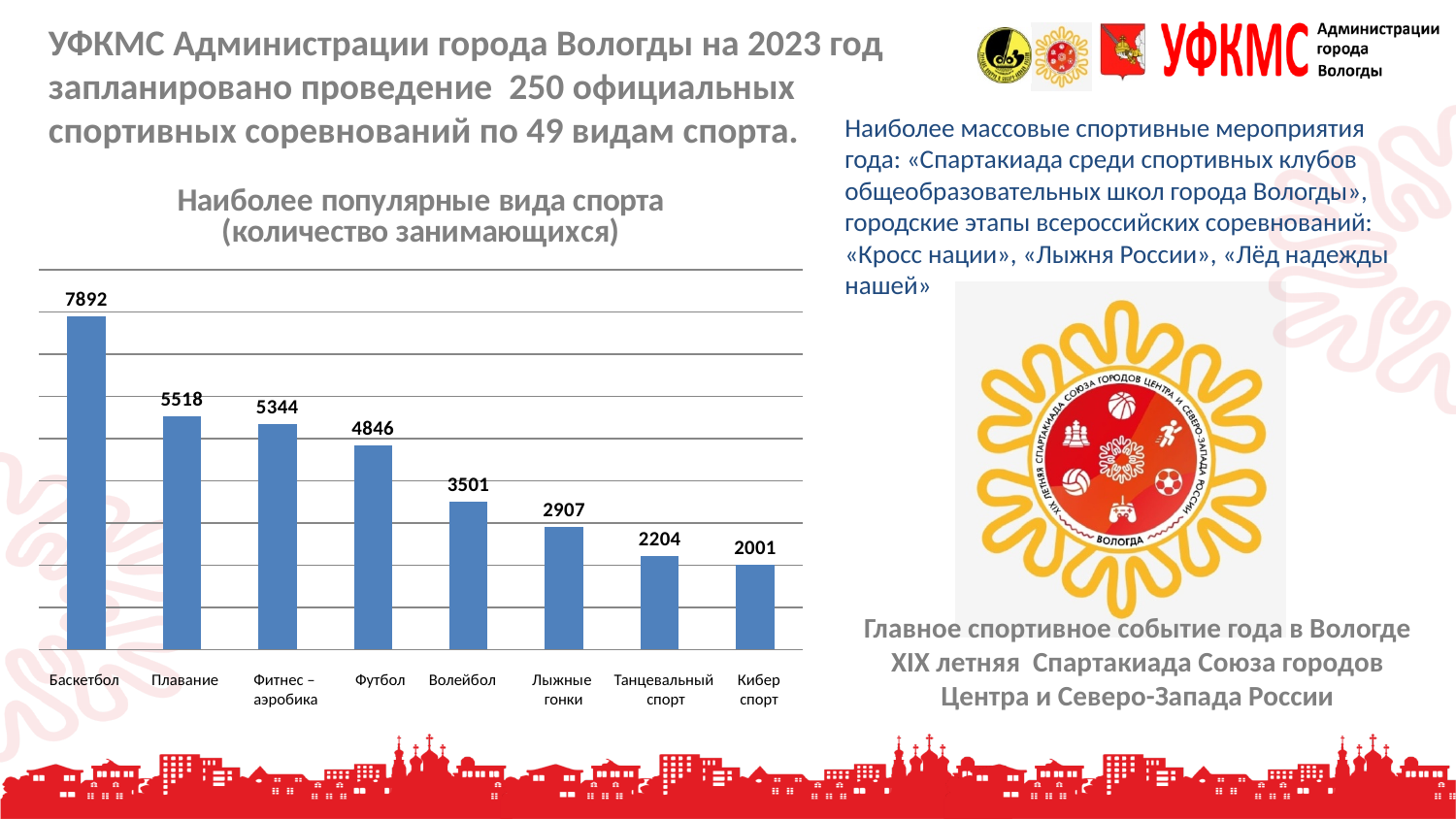
Which category has the highest value? Баскетбол Which category has the lowest value? Кибер спорт What is the value for Волейбол? 3501 What is the value for Баскетбол? 7892 Do the values rise or fall from left to right along the x axis? fall What is the value for Лыжные гонки? 2907 What is the difference between the values for Танцевальный спорт and Кибер спорт? 203 Which is larger, the value for Футбол or the value for Волейбол? Футбол How many categories are shown in the chart? 8 What is the difference between the values for Баскетбол and Плавание? 2374 What is the title of the chart? Наиболее популярные вида спорта (количество занимающихся) What kind of chart is shown on the slide? bar chart